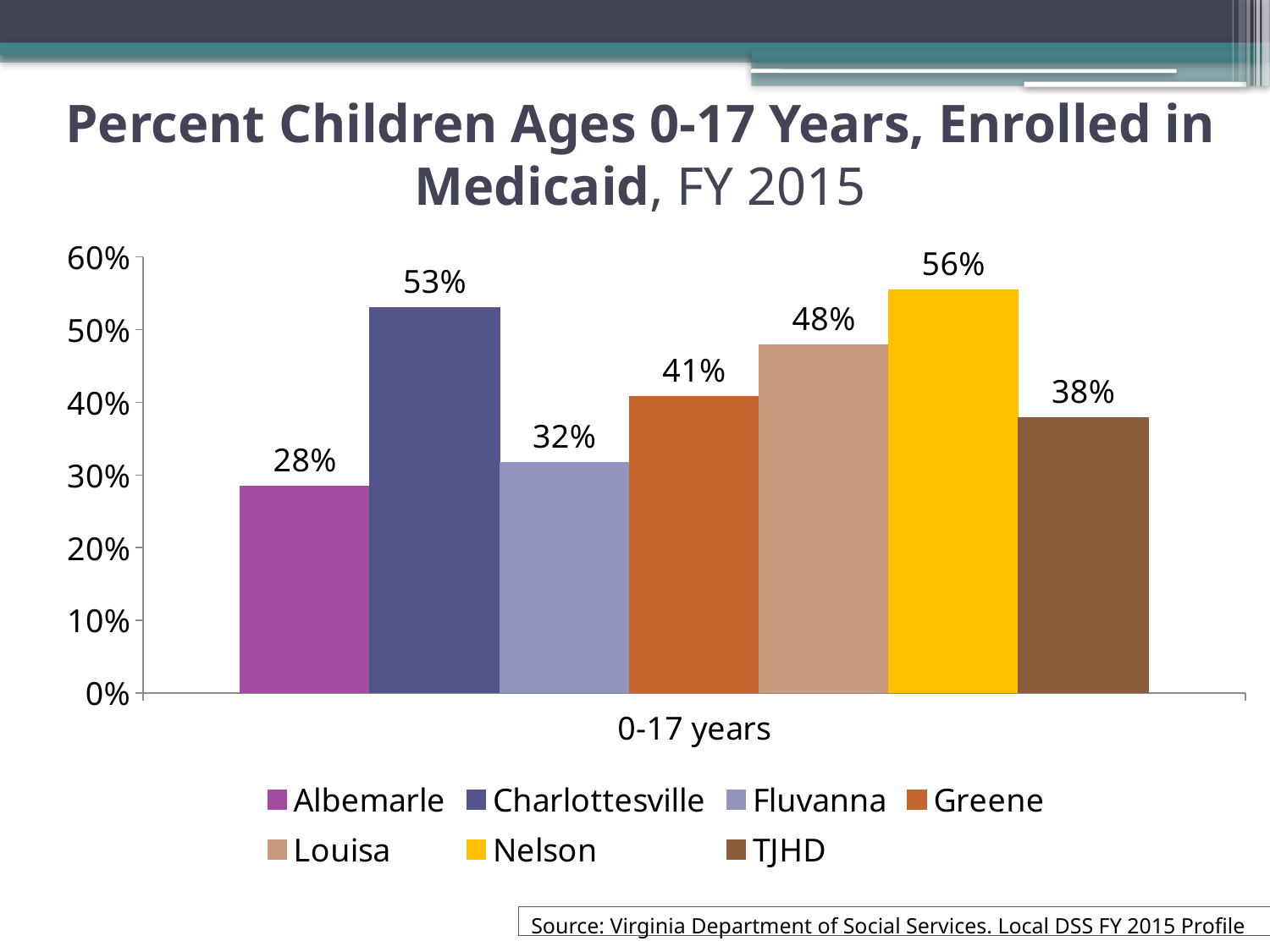
What is the difference between the values for Nelson and Albemarle? 28% What is the value shown for Charlottesville? 53% What kind of chart is shown on the slide? Bar chart What is the value shown for Louisa? 48% Which locality has the lowest percent of children enrolled in Medicaid? Albemarle What is the value shown for TJHD? 38% How many series does the legend list? 7 What colour is the bar for Nelson? Yellow What is the difference between the values for Greene and Fluvanna? 9% What percent of children ages 0-17 years in Albemarle are enrolled in Medicaid? 28% Which is larger, the value for Louisa or the value for Greene? Louisa Which locality has the highest percent of children enrolled in Medicaid? Nelson